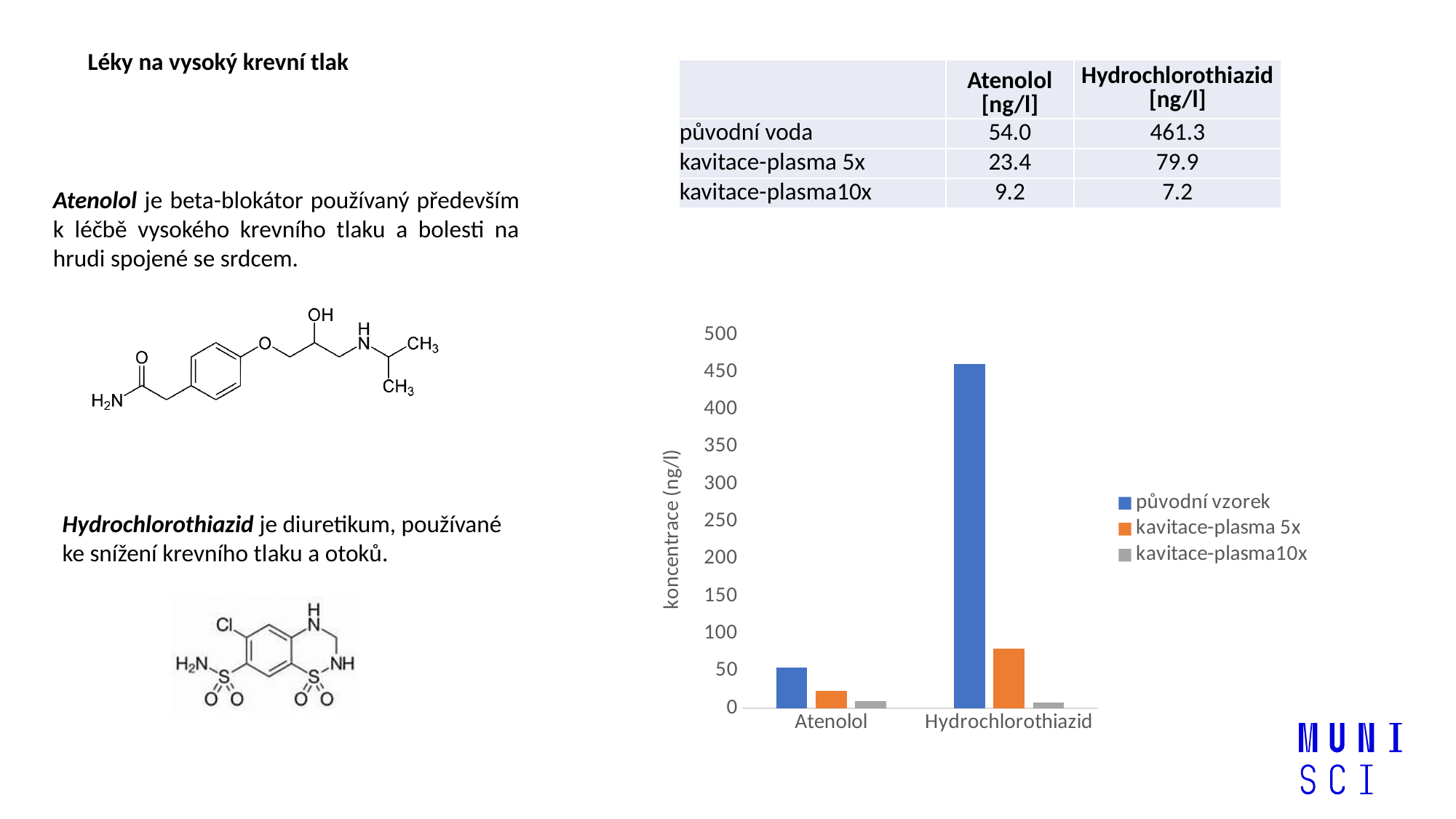
Is the value for Hydrochlorothiazid in the původní vzorek series greater or less than 400? greater Which series is shown in orange in the chart? kavitace-plasma 5x What kind of chart is shown on the slide? bar chart Which series has the lowest bar for Hydrochlorothiazid? kavitace-plasma10x What is the label of the y axis of the chart? koncentrace (ng/l) Which is larger: the kavitace-plasma 5x value for Atenolol or the kavitace-plasma 5x value for Hydrochlorothiazid? Hydrochlorothiazid How many categories are shown on the x axis of the chart? 2 Is the value for Hydrochlorothiazid in the kavitace-plasma 5x series greater or less than 100? less Is the value for Atenolol in the původní vzorek series greater or less than 100? less Which category has the highest bar in the původní vzorek series? Hydrochlorothiazid How many series does the chart legend list? 3 According to the table on the slide, what is the Atenolol concentration in the původní voda sample? 54.0